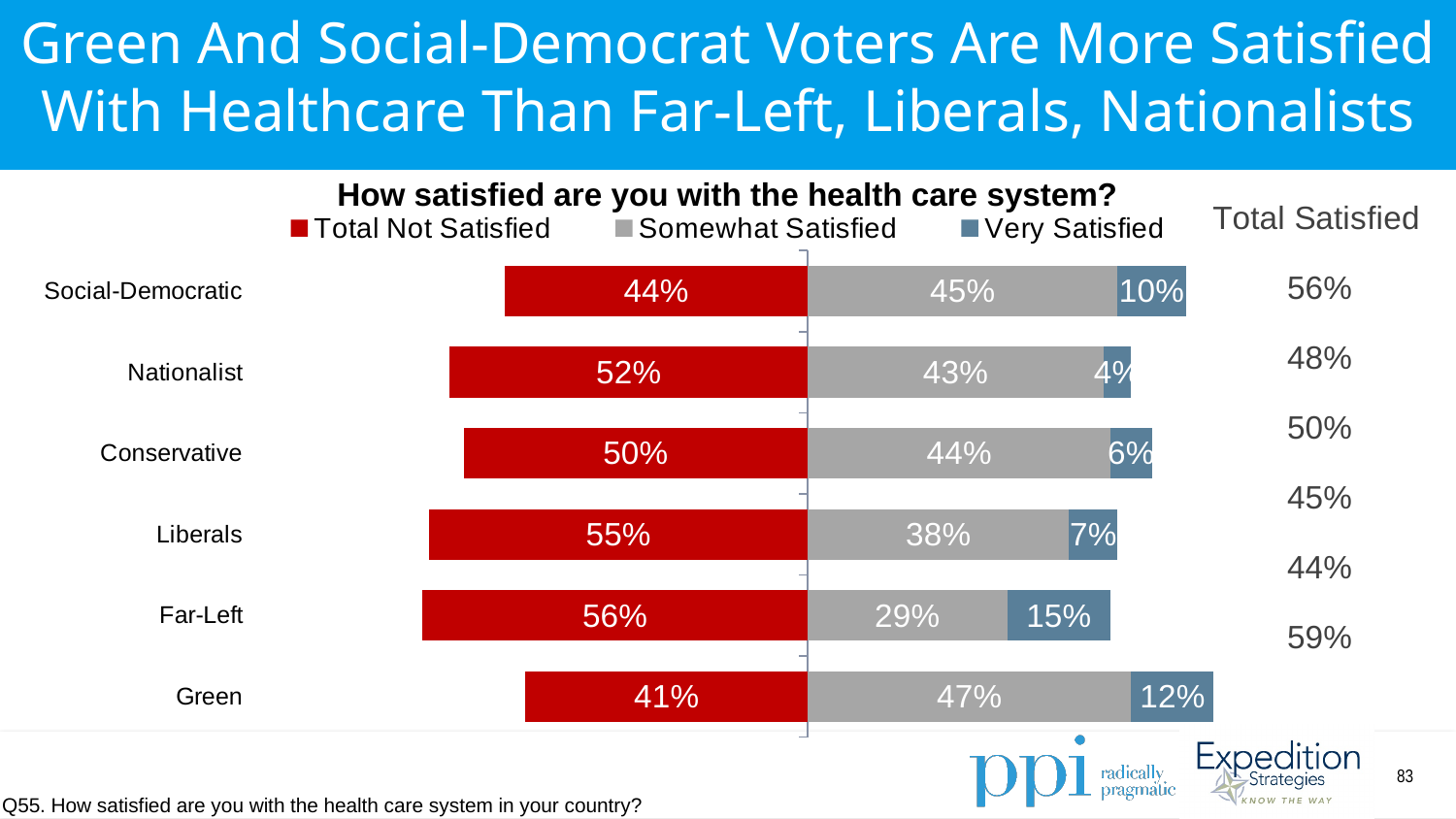
What percentage of Far-Left voters are Very Satisfied with the health care system? 15% Which voter group has the highest Total Not Satisfied value? Far-Left What is the title of the chart? How satisfied are you with the health care system? Which is larger, the Somewhat Satisfied value for Conservative voters or for Far-Left voters? Conservative How many series does the legend list? 3 Which voter group has the lowest Very Satisfied value? Nationalist What is the Somewhat Satisfied value for Green voters? 47% How many voter groups are shown in the chart? 6 What kind of chart is shown on the slide? Stacked bar chart What is the Total Not Satisfied value for Nationalist voters? 52% What is the Total Satisfied value shown for Green voters? 59% What is the difference between the Total Not Satisfied values for Liberals and Social-Democratic voters? 11%